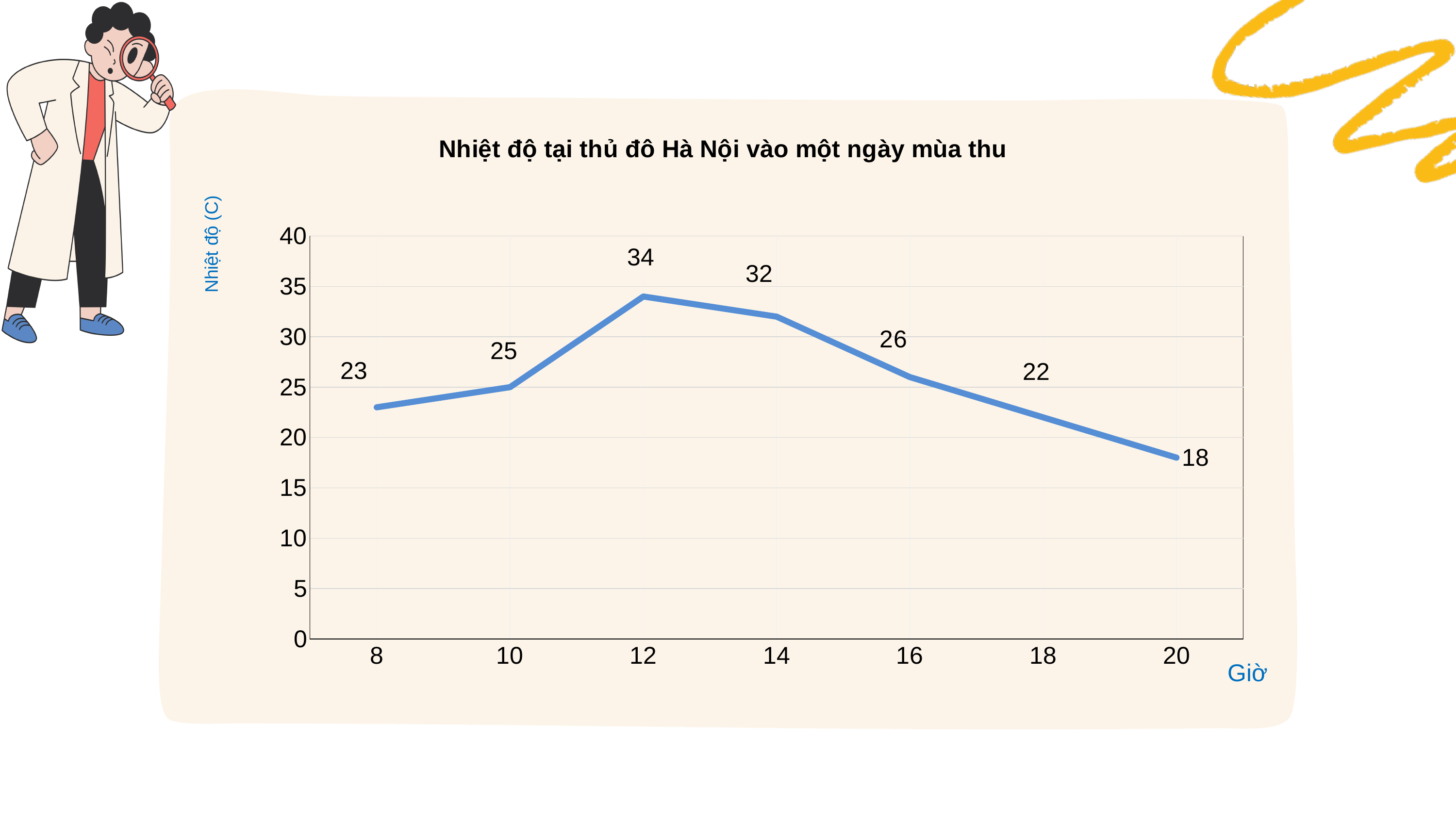
What is the temperature at 12 o'clock? 34 What is the title of the chart? Nhiệt độ tại thủ đô Hà Nội vào một ngày mùa thu How many data points are plotted on the chart? 7 Is the temperature at 18 greater or less than 25? less What is the temperature at 20 o'clock? 18 At which hour is the temperature highest? 12 Which is higher, the temperature at 10 or the temperature at 16? 16 At which hour is the temperature lowest? 20 What is the difference between the temperature at 12 and the temperature at 14? 2 What kind of chart is shown on the slide? line chart What is the temperature at 8 o'clock? 23 What is the difference between the temperature at 8 and the temperature at 20? 5